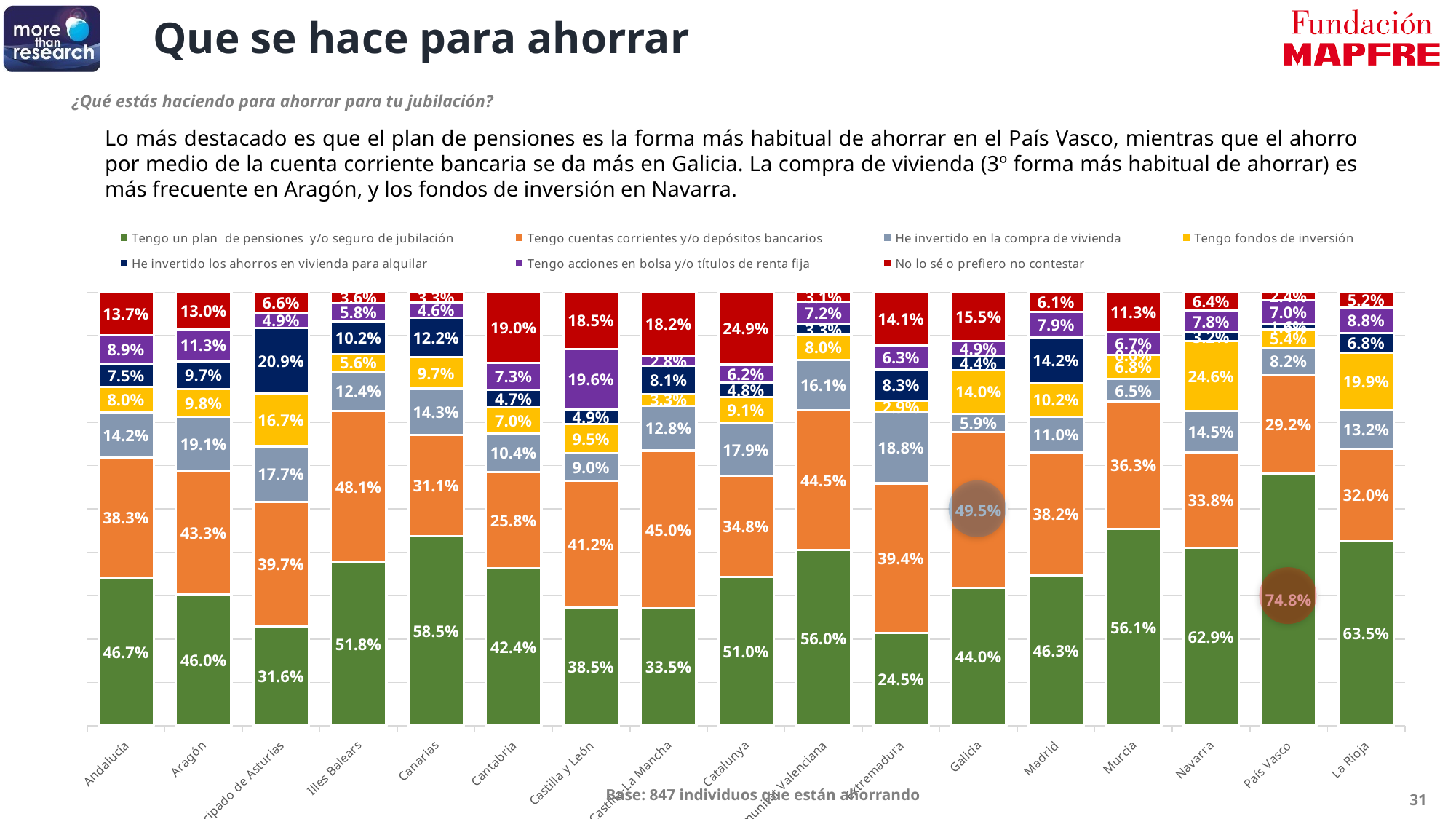
Which region has the highest value for 'No lo sé o prefiero no contestar'? Catalunya What is the value for 'Tengo cuentas corrientes y/o depósitos bancarios' in Galicia? 49.5% How many regions (categories) are shown on the x axis? 17 Which region has the lowest value for 'Tengo un plan de pensiones y/o seguro de jubilación'? Extremadura What is the value for 'Tengo un plan de pensiones y/o seguro de jubilación' in País Vasco? 74.8% What is the difference between the 'Tengo un plan de pensiones y/o seguro de jubilación' values for País Vasco and Navarra? 11.9 percentage points How many series does the legend list? 7 What is the value for 'He invertido en la compra de vivienda' in Aragón? 19.1% What is the value for 'Tengo fondos de inversión' in Navarra? 24.6% Which region has the highest value for 'Tengo un plan de pensiones y/o seguro de jubilación'? País Vasco Which is larger: the 'Tengo fondos de inversión' value in Navarra or in La Rioja? Navarra What kind of chart is shown on the slide? Stacked bar chart